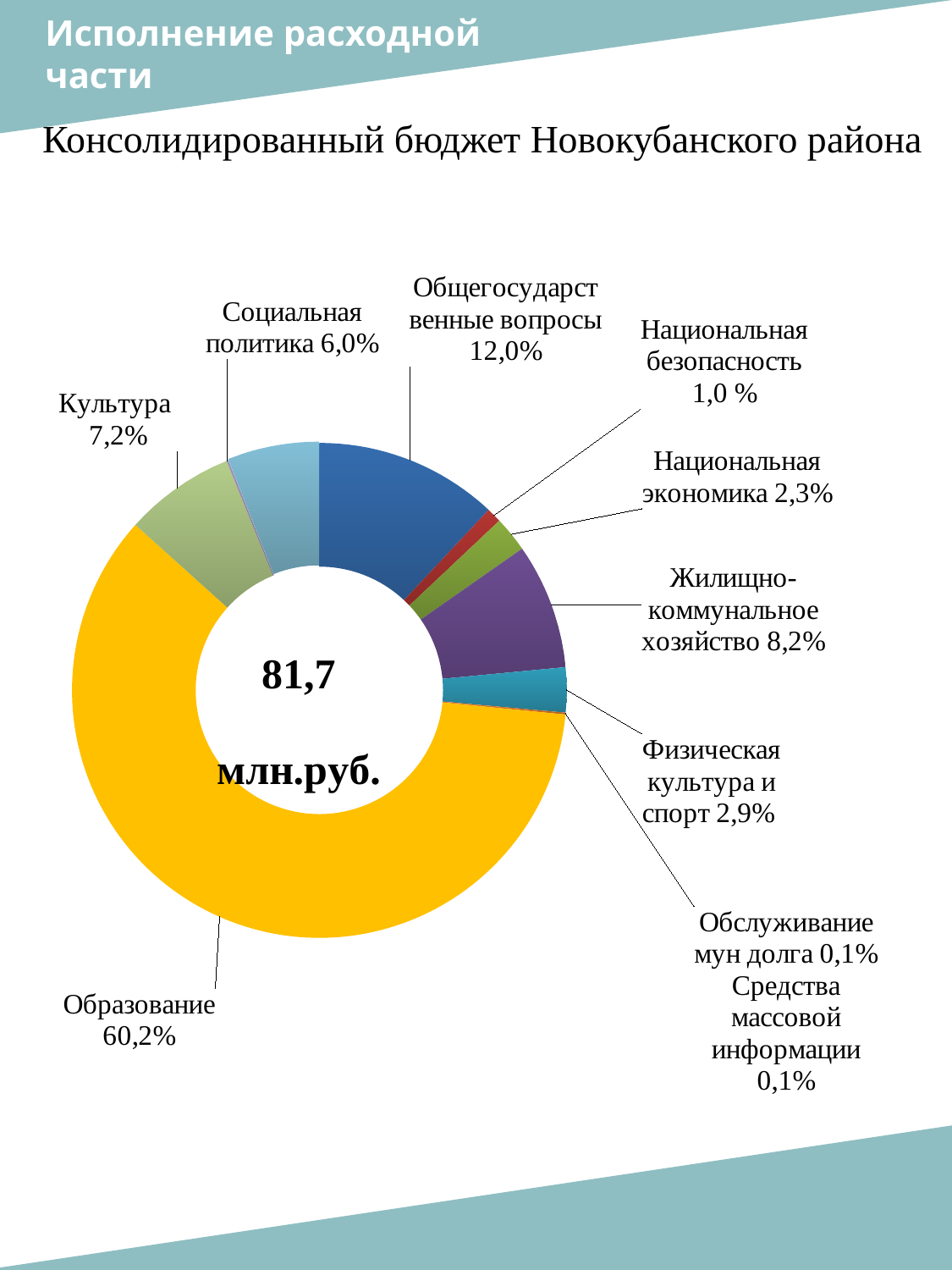
Which category has the largest share of the chart? Образование What share of the budget goes to Образование? 60,2% What is the difference in percentage points between Общегосударственные вопросы and Культура? 4,8 What share is labelled for Общегосударственные вопросы? 12,0% Which is larger, the share for Национальная экономика or the share for Физическая культура и спорт? Физическая культура и спорт What kind of chart is shown on the slide? Doughnut (pie) chart What percentage is shown for Жилищно-коммунальное хозяйство? 8,2% How many categories are shown in the chart? 10 Which is larger, the share for Культура or the share for Социальная политика? Культура What percentage is shown for Физическая культура и спорт? 2,9% What total value is printed in the centre of the chart? 81,7 млн.руб. What is the combined share of Обслуживание мун долга and Средства массовой информации? 0,2%